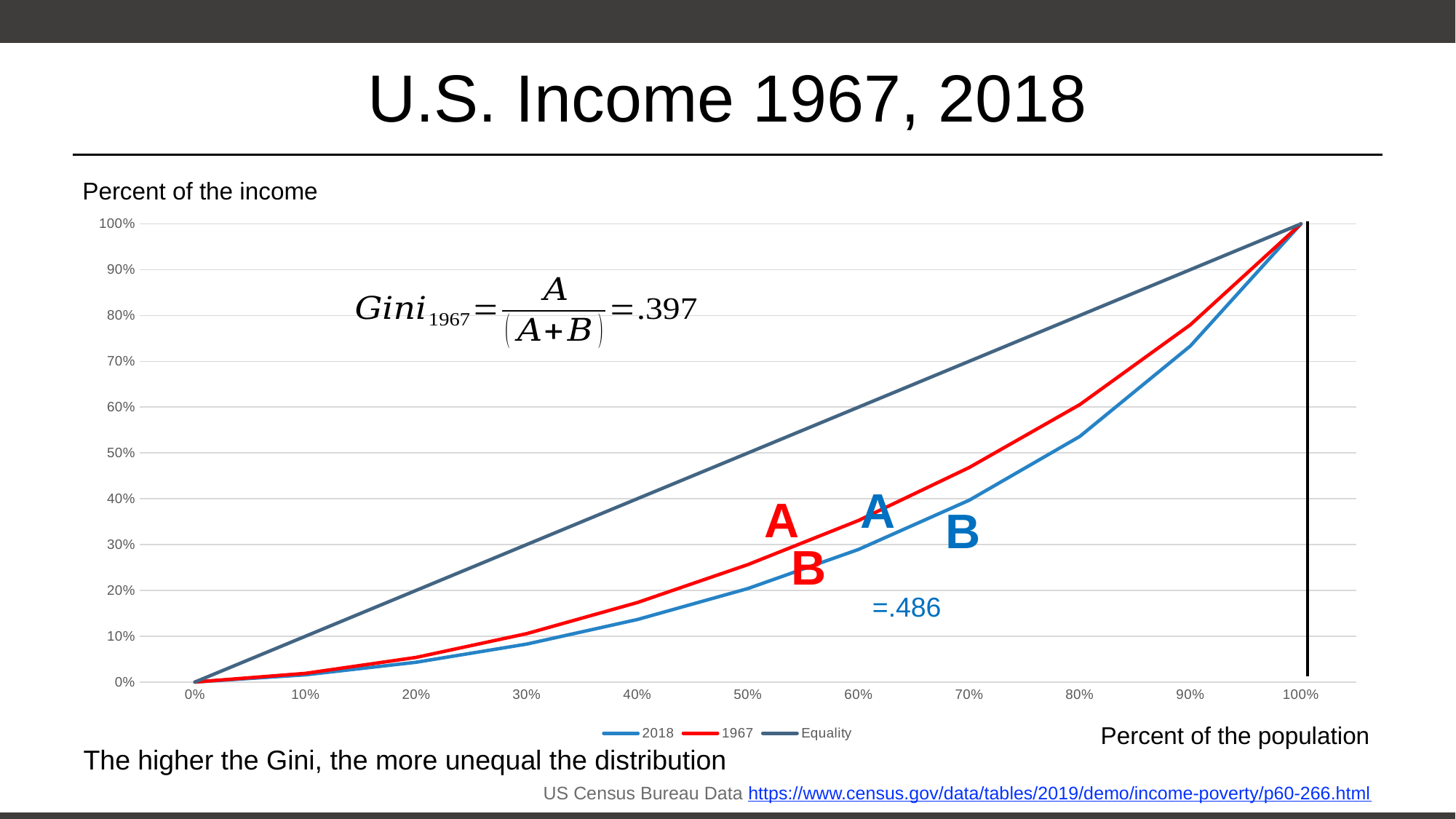
Is the value for 2018 at 90% of the population greater or less than 80%? less How many series does the legend list? 3 What is the Gini value printed for 2018? .486 What are the three series named in the legend? 2018, 1967, Equality What is the Gini value printed for 1967? .397 What kind of chart is shown on the slide? line chart At 80% of the population, which series has the higher value, 1967 or 2018? 1967 What is the value of the 2018 line at 100% of the population? 100% What is the value of the Equality line at 50% of the population? 50% Do the values of the 1967 line rise or fall as the percent of the population increases? rise Is the value for 2018 at 80% of the population greater or less than 60%? less What is the title of the slide's chart? U.S. Income 1967, 2018